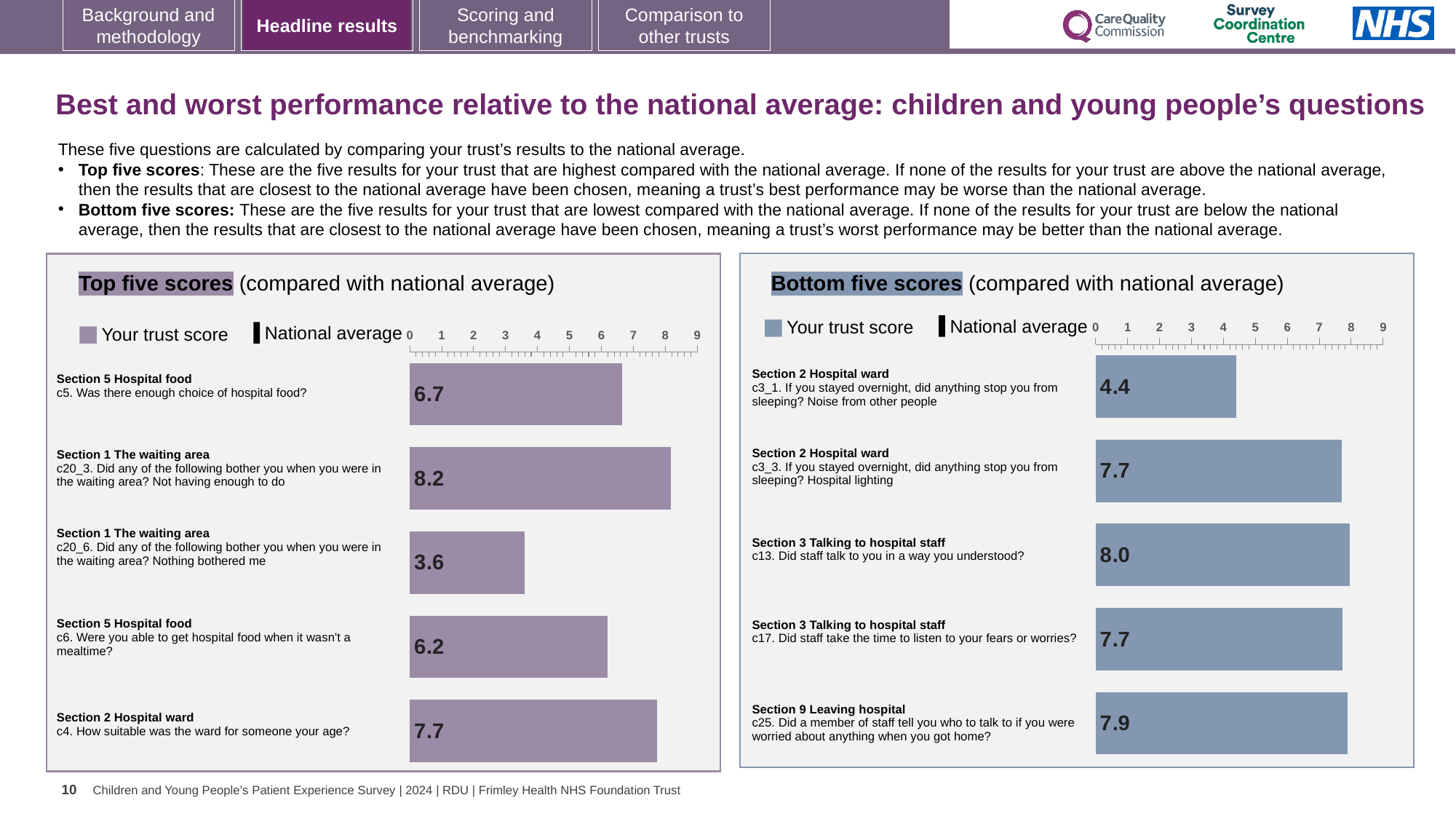
In the Top five scores chart, what is the difference between the trust scores for c20_3 and c20_6? 4.6 In the Bottom five scores chart, what is the difference between the trust scores for c13 and c3_1? 3.6 In the Bottom five scores chart, what is the trust score for c25 (Did a member of staff tell you who to talk to if you were worried about anything when you got home?)? 7.9 In the Bottom five scores chart, which has the larger trust score: c3_3 (Hospital lighting) or c25 (told who to talk to when you got home)? c25 How many bars are shown in the Bottom five scores chart? 5 In the Top five scores chart, what is the trust score for c4 (How suitable was the ward for someone your age?)? 7.7 In the Top five scores chart, which question has the highest trust score? c20_3. Did any of the following bother you when you were in the waiting area? Not having enough to do In the Bottom five scores chart, which question has the lowest trust score? c3_1. If you stayed overnight, did anything stop you from sleeping? Noise from other people In the Top five scores chart, which question has the lowest trust score? c20_6. Did any of the following bother you when you were in the waiting area? Nothing bothered me In the Bottom five scores chart, what is the trust score for c13 (Did staff talk to you in a way you understood?)? 8.0 What type of chart is the Top five scores chart? Bar chart In the Top five scores chart, what is the trust score for c5 (Was there enough choice of hospital food?)? 6.7